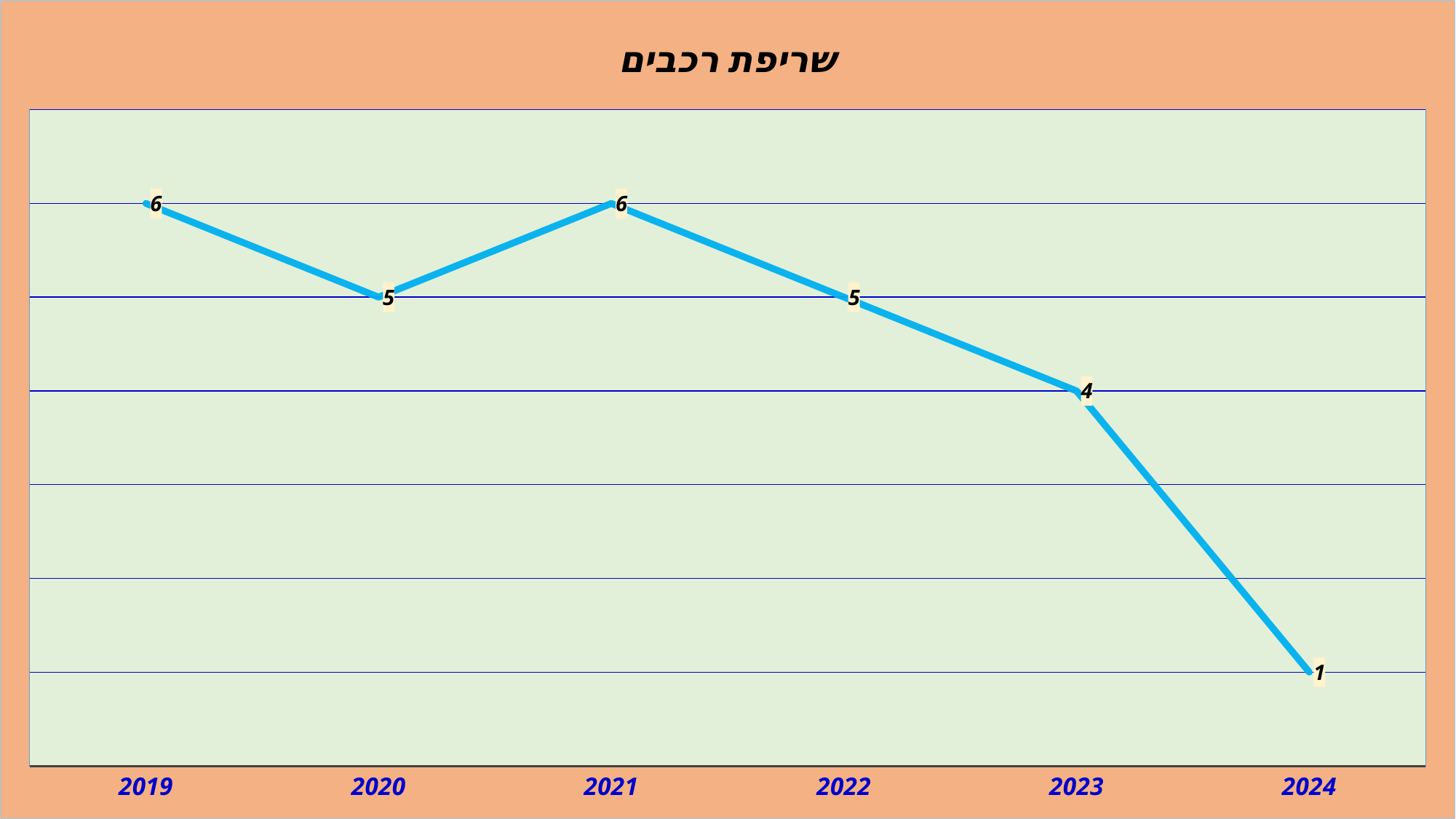
Which year has the lowest value? 2024 What is the title of the chart? שריפת רכבים What is the difference between the values for 2023 and 2024? 3 What is the value for 2019? 6 What is the value for 2024? 1 What kind of chart is this? line chart Do the values rise or fall from 2021 to 2024? fall What is the difference between the values for 2021 and 2022? 1 What is the value for 2023? 4 What is the value for 2020? 5 Which is larger, the value for 2021 or the value for 2023? 2021 How many years are plotted on the x axis? 6